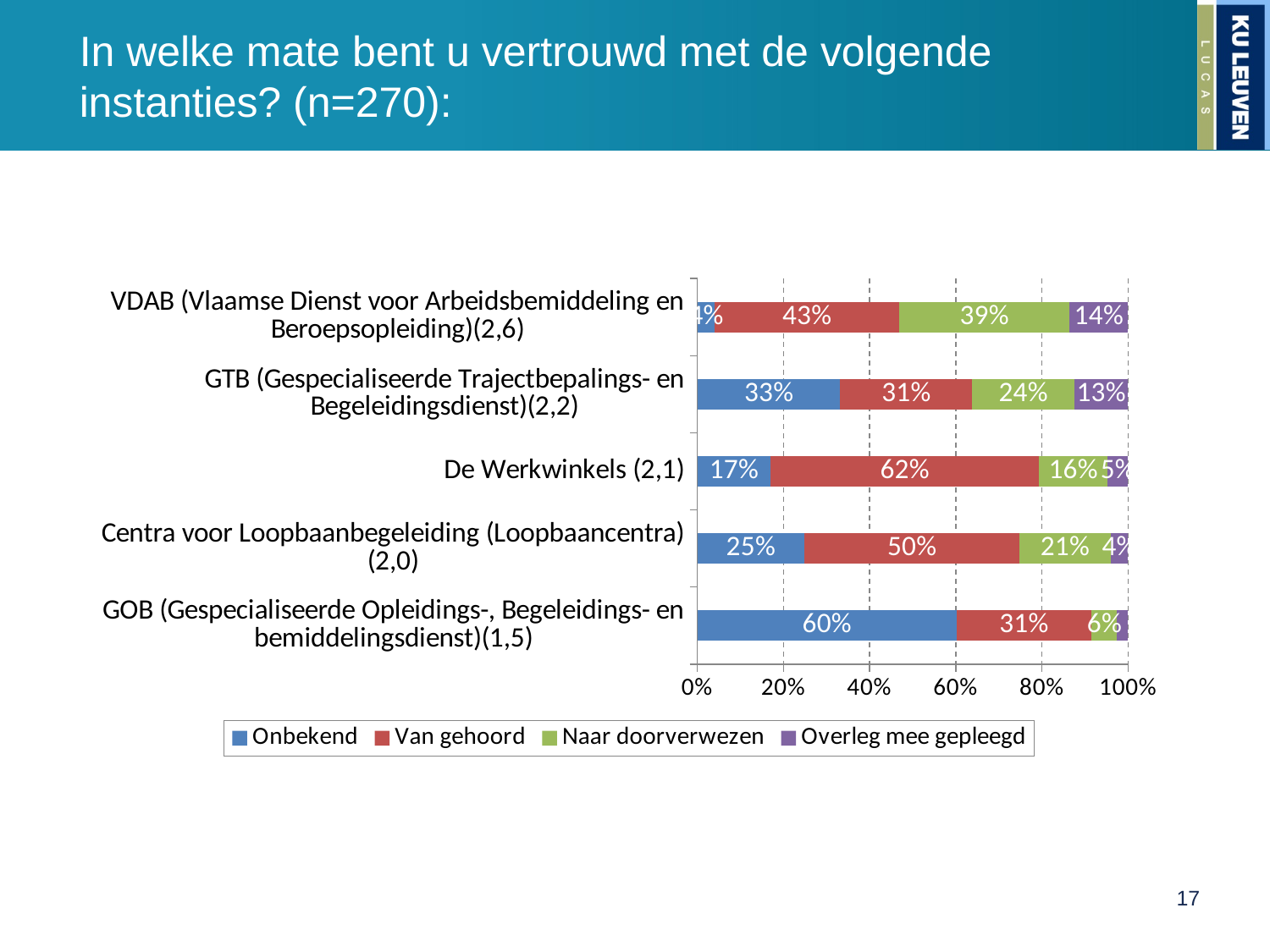
How many categories (instanties) are plotted on the chart? 5 Which category has the highest 'Van gehoord' value? De Werkwinkels (2,1) What is the difference between the 'Van gehoord' values for De Werkwinkels (2,1) and Centra voor Loopbaanbegeleiding (Loopbaancentra)(2,0)? 12% Which category has the highest 'Onbekend' value? GOB (Gespecialiseerde Opleidings-, Begeleidings- en bemiddelingsdienst)(1,5) What is the 'Overleg mee gepleegd' value for GTB (Gespecialiseerde Trajectbepalings- en Begeleidingsdienst)(2,2)? 13% How many series does the legend list? 4 What is the 'Naar doorverwezen' value for VDAB (Vlaamse Dienst voor Arbeidsbemiddeling en Beroepsopleiding)(2,6)? 39% Which is larger: the 'Onbekend' value for GTB (2,2) or the 'Onbekend' value for Centra voor Loopbaanbegeleiding (2,0)? GTB (2,2) What is the 'Van gehoord' value for De Werkwinkels (2,1)? 62% What is the 'Onbekend' value for GOB (Gespecialiseerde Opleidings-, Begeleidings- en bemiddelingsdienst)(1,5)? 60% What kind of chart is shown on the slide? stacked bar chart Which legend entry is shown in red? Van gehoord